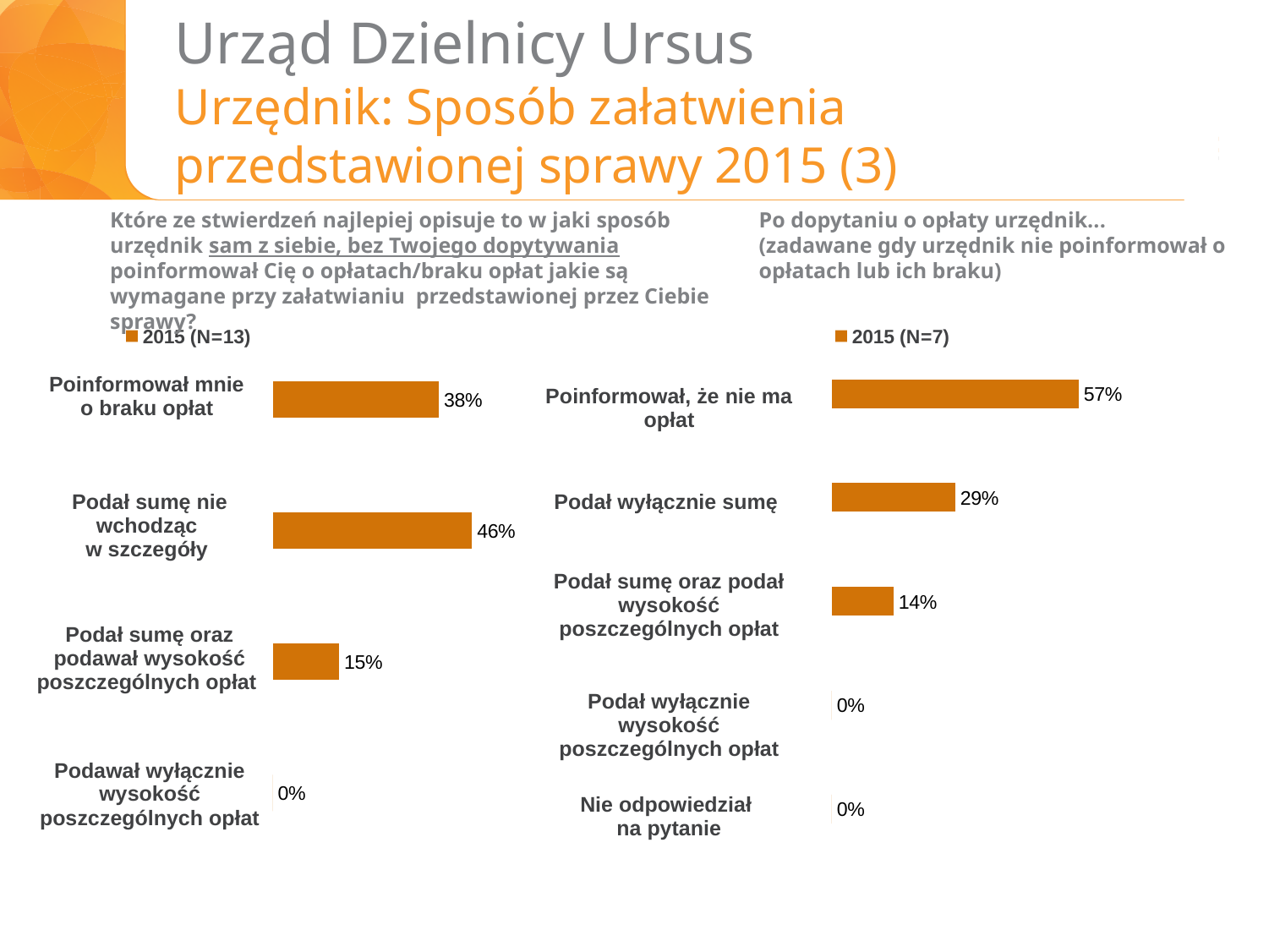
What type of chart is the left chart? Bar chart In the right chart, what is the difference between 'Poinformował, że nie ma opłat' and 'Podał wyłącznie sumę'? 28% In the right chart, what is the value for 'Podał sumę oraz podał wysokość poszczególnych opłat'? 14% In the left chart, what is the value for 'Podał sumę nie wchodząc w szczegóły'? 46% In the left chart, which category has the highest value? Podał sumę nie wchodząc w szczegóły In the right chart, which is larger: 'Podał wyłącznie sumę' or 'Podał sumę oraz podał wysokość poszczególnych opłat'? Podał wyłącznie sumę In the left chart, what is the value for 'Poinformował mnie o braku opłat'? 38% In the right chart, which category has the highest value? Poinformował, że nie ma opłat How many categories does the left chart show? 4 In the right chart, what is the value for 'Poinformował, że nie ma opłat'? 57% In the left chart, what is the difference between 'Podał sumę nie wchodząc w szczegóły' and 'Poinformował mnie o braku opłat'? 8% How many categories does the right chart show? 5